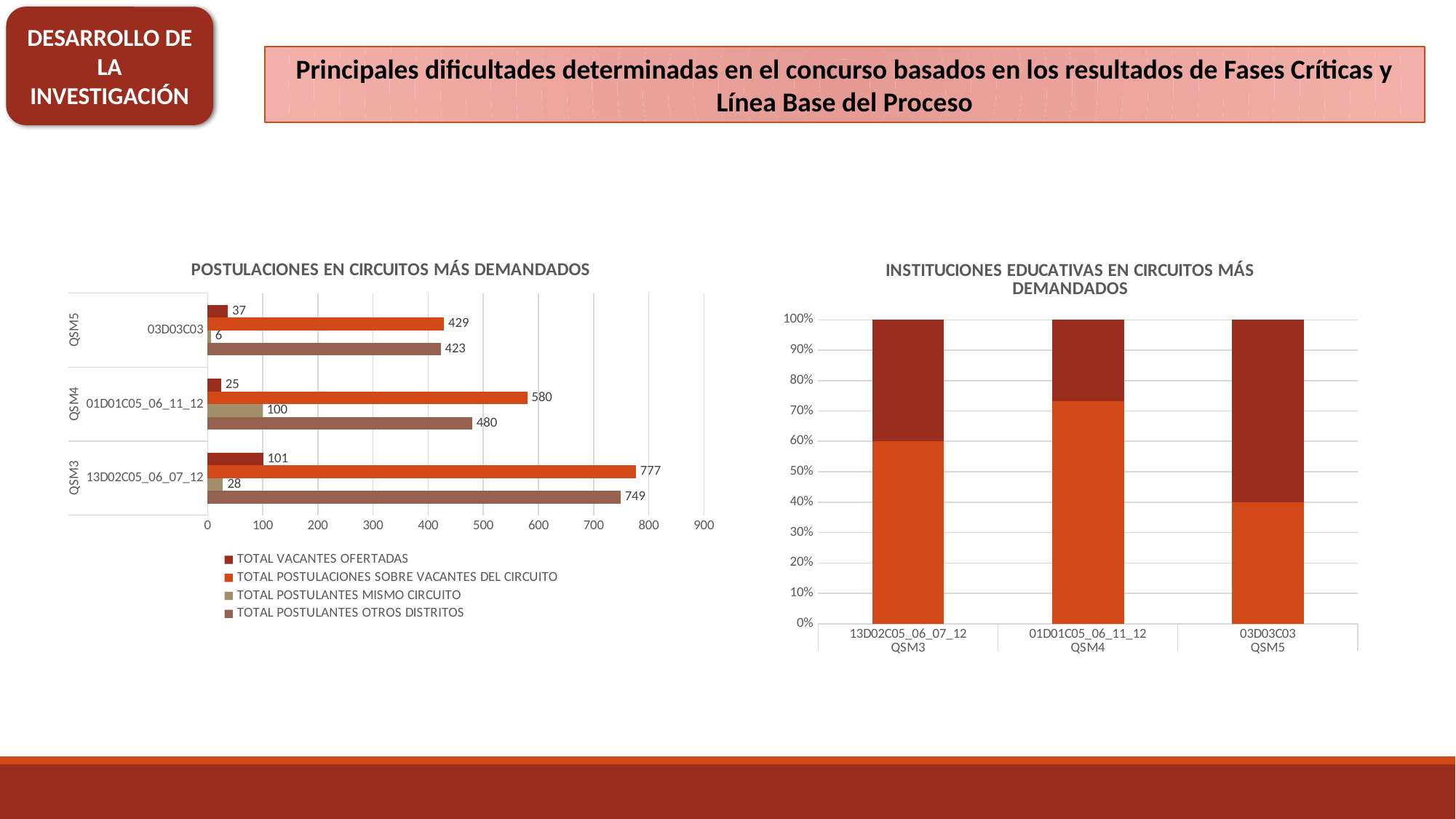
In the chart 'POSTULACIONES EN CIRCUITOS MÁS DEMANDADOS', which is larger for 03D03C03 (QSM5): TOTAL POSTULACIONES SOBRE VACANTES DEL CIRCUITO or TOTAL POSTULANTES OTROS DISTRITOS? TOTAL POSTULACIONES SOBRE VACANTES DEL CIRCUITO How many series does the legend of the chart 'POSTULACIONES EN CIRCUITOS MÁS DEMANDADOS' list? 4 In the chart 'POSTULACIONES EN CIRCUITOS MÁS DEMANDADOS', what is the difference between TOTAL POSTULACIONES SOBRE VACANTES DEL CIRCUITO and TOTAL POSTULANTES OTROS DISTRITOS for 01D01C05_06_11_12 (QSM4)? 100 How many circuits are shown in the chart 'INSTITUCIONES EDUCATIVAS EN CIRCUITOS MÁS DEMANDADOS'? 3 In the chart 'POSTULACIONES EN CIRCUITOS MÁS DEMANDADOS', what is the value of TOTAL VACANTES OFERTADAS for 03D03C03 (QSM5)? 37 What kind of chart is 'POSTULACIONES EN CIRCUITOS MÁS DEMANDADOS'? Bar chart In the chart 'POSTULACIONES EN CIRCUITOS MÁS DEMANDADOS', what is the value of TOTAL POSTULACIONES SOBRE VACANTES DEL CIRCUITO for 13D02C05_06_07_12 (QSM3)? 777 In the chart 'POSTULACIONES EN CIRCUITOS MÁS DEMANDADOS', which circuit has the lowest value of TOTAL VACANTES OFERTADAS? 01D01C05_06_11_12 (QSM4) In the chart 'POSTULACIONES EN CIRCUITOS MÁS DEMANDADOS', what is the value of TOTAL POSTULANTES MISMO CIRCUITO for 01D01C05_06_11_12 (QSM4)? 100 In the chart 'INSTITUCIONES EDUCATIVAS EN CIRCUITOS MÁS DEMANDADOS', is the orange (lower) segment for 01D01C05_06_11_12 QSM4 greater or less than 50%? greater In the chart 'INSTITUCIONES EDUCATIVAS EN CIRCUITOS MÁS DEMANDADOS', is the orange (lower) segment for 03D03C03 QSM5 greater or less than 50%? less In the chart 'POSTULACIONES EN CIRCUITOS MÁS DEMANDADOS', which circuit has the highest value of TOTAL POSTULANTES OTROS DISTRITOS? 13D02C05_06_07_12 (QSM3)